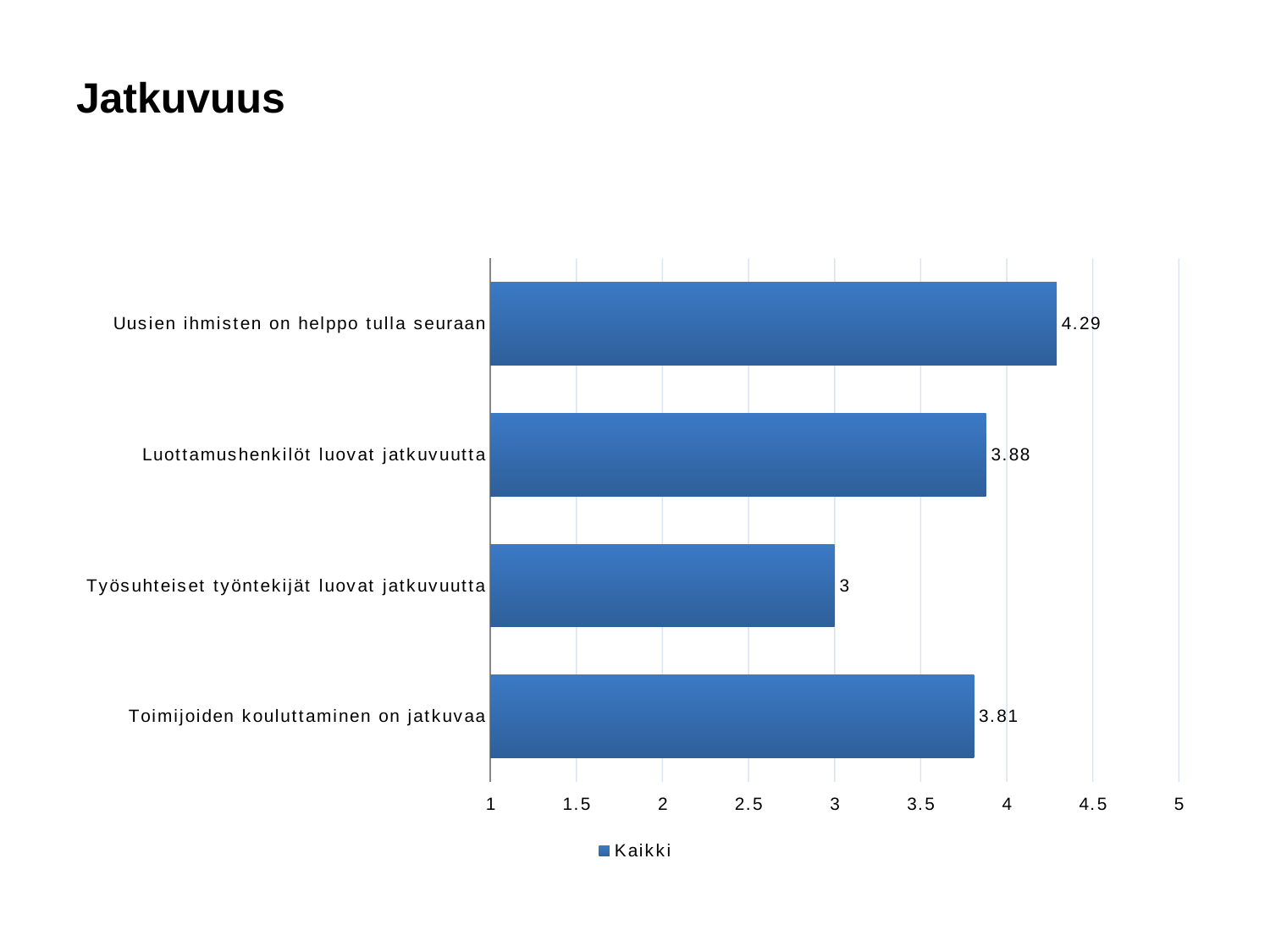
Which is larger: the value for "Luottamushenkilöt luovat jatkuvuutta" or for "Toimijoiden kouluttaminen on jatkuvaa"? Luottamushenkilöt luovat jatkuvuutta What is the difference between the values for "Uusien ihmisten on helppo tulla seuraan" and "Työsuhteiset työntekijät luovat jatkuvuutta"? 1.29 Is the value for "Toimijoiden kouluttaminen on jatkuvaa" greater or less than 3.5? greater Which category has the highest value? Uusien ihmisten on helppo tulla seuraan What is the value for "Luottamushenkilöt luovat jatkuvuutta"? 3.88 How many series does the legend list? 1 What is the value for "Uusien ihmisten on helppo tulla seuraan"? 4.29 How many categories are shown in the chart? 4 Which category has the lowest value? Työsuhteiset työntekijät luovat jatkuvuutta What is the value for "Toimijoiden kouluttaminen on jatkuvaa"? 3.81 What is the value for "Työsuhteiset työntekijät luovat jatkuvuutta"? 3 What kind of chart is shown on the slide? bar chart